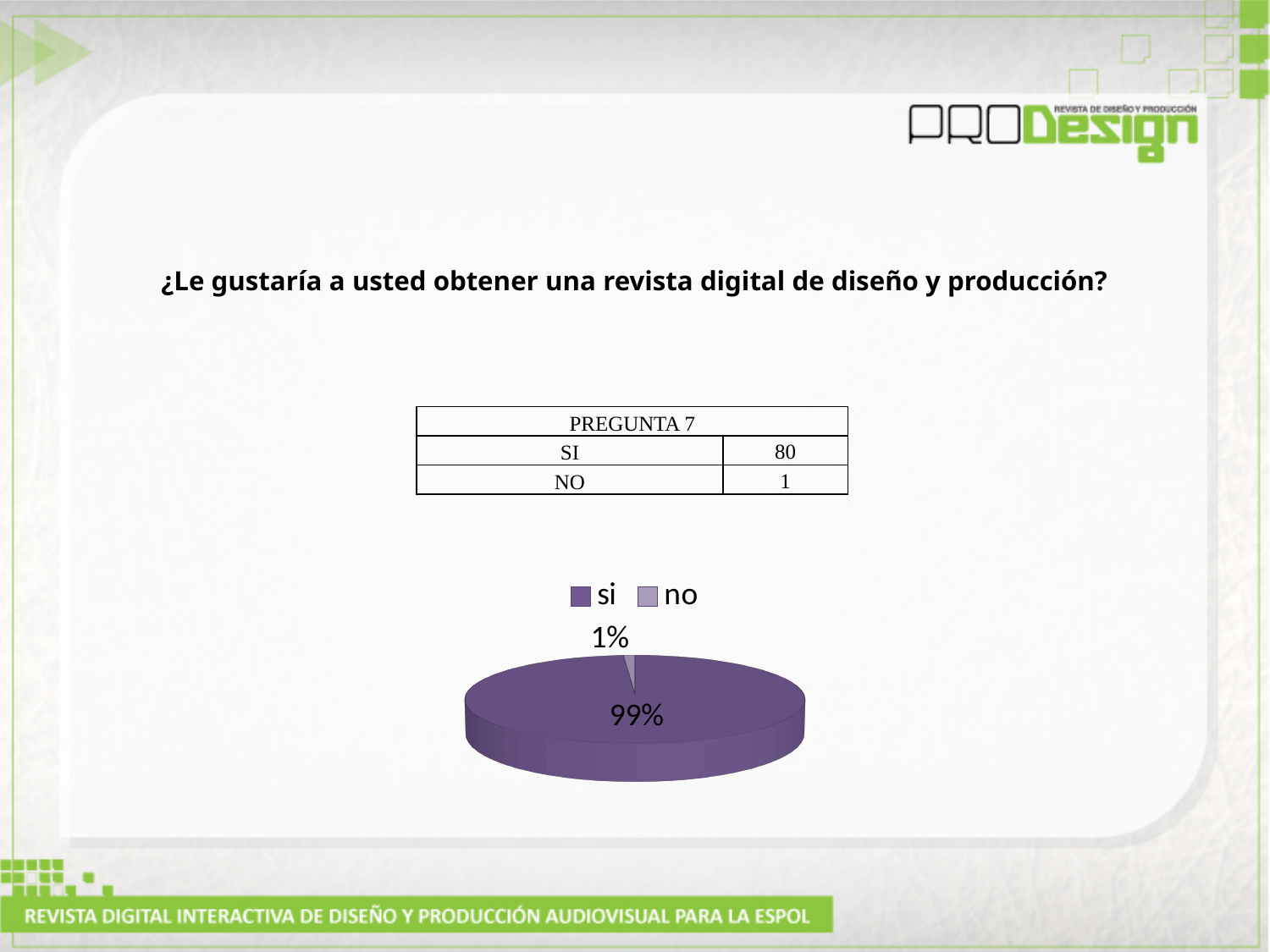
What share of the pie does the "no" slice represent? 1% How many entries does the legend list? 2 Which is larger, the "si" slice or the "no" slice? si What kind of chart is shown on the slide? pie chart Which slice of the pie is the largest? si What are the two legend entries of the pie chart? si and no What is the difference in percentage points between the "si" and "no" slices? 98 percentage points What colour is the "si" slice of the pie chart? purple What share of the pie does the "si" slice represent? 99% Is the share of the "si" slice greater or less than 50%? greater How many slices does the pie chart have? 2 Which slice of the pie is the smallest? no